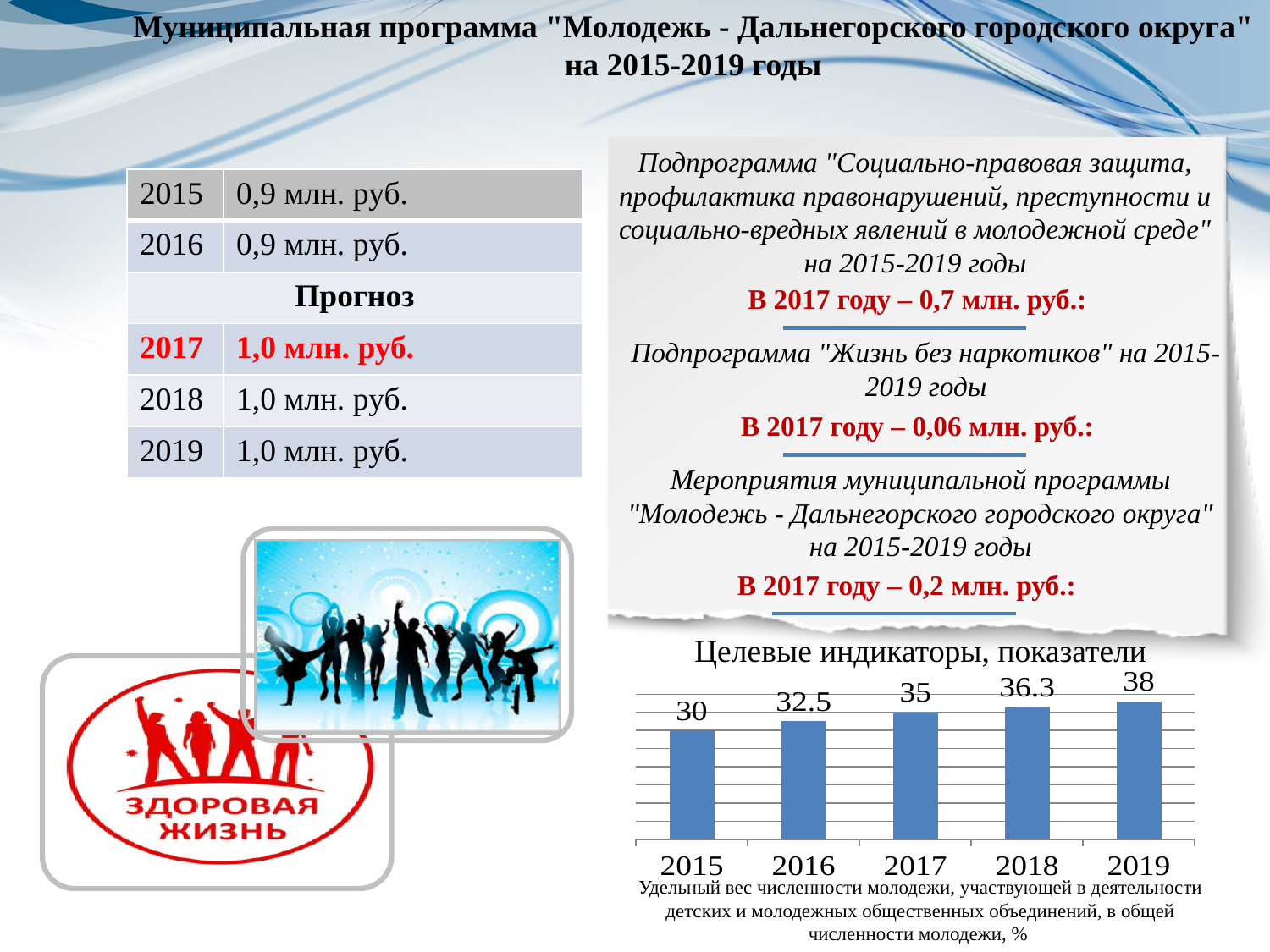
Which is larger in the chart, the value for 2017 or the value for 2018? 2018 What is the value for 2015 in the chart titled "Целевые индикаторы, показатели"? 30 What kind of chart is shown under the heading "Целевые индикаторы, показатели"? bar chart What is the value for 2018 in the chart? 36.3 What is the value for 2019 in the chart? 38 What is the value for 2016 in the chart? 32.5 Which year has the lowest value in the chart? 2015 What is the difference between the values for 2017 and 2016 in the chart? 2.5 Which year has the highest value in the chart? 2019 What is the difference between the values for 2019 and 2015 in the chart? 8 Do the values in the chart rise or fall from 2015 to 2019? rise How many years are shown on the x axis of the chart? 5